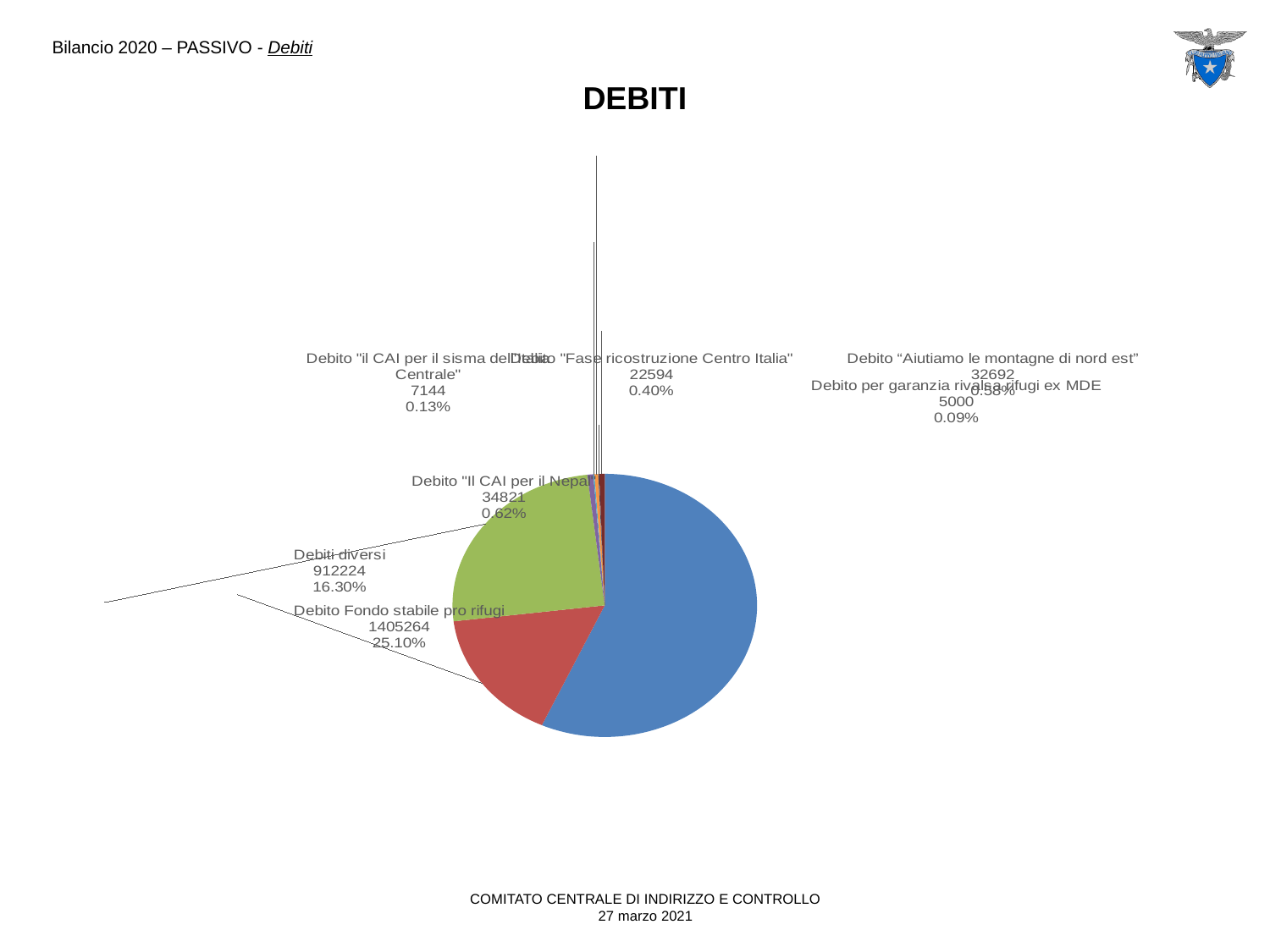
Which labeled category has the smallest value? Debito per garanzia rivalsa rifugi ex MDE Which is larger, Debiti diversi or Debito Fondo stabile pro rifugi? Debito Fondo stabile pro rifugi What share of the pie does Debito Fondo stabile pro rifugi represent? 25.10% What is the value shown for Debito "Il CAI per il Nepal"? 34821 What percentage is shown for Debito "Fase ricostruzione Centro Italia"? 0.40% What share of the pie does Debiti diversi represent? 16.30% What is the difference between the values for Debito Fondo stabile pro rifugi and Debiti diversi? 493040 What is the value shown for Debito per garanzia rivalsa rifugi ex MDE? 5000 What is the value shown for Debito "il CAI per il sisma dell'Italia Centrale"? 7144 What is the title of the chart? DEBITI What is the value shown for Debiti diversi? 912224 What kind of chart is shown on the slide? pie chart